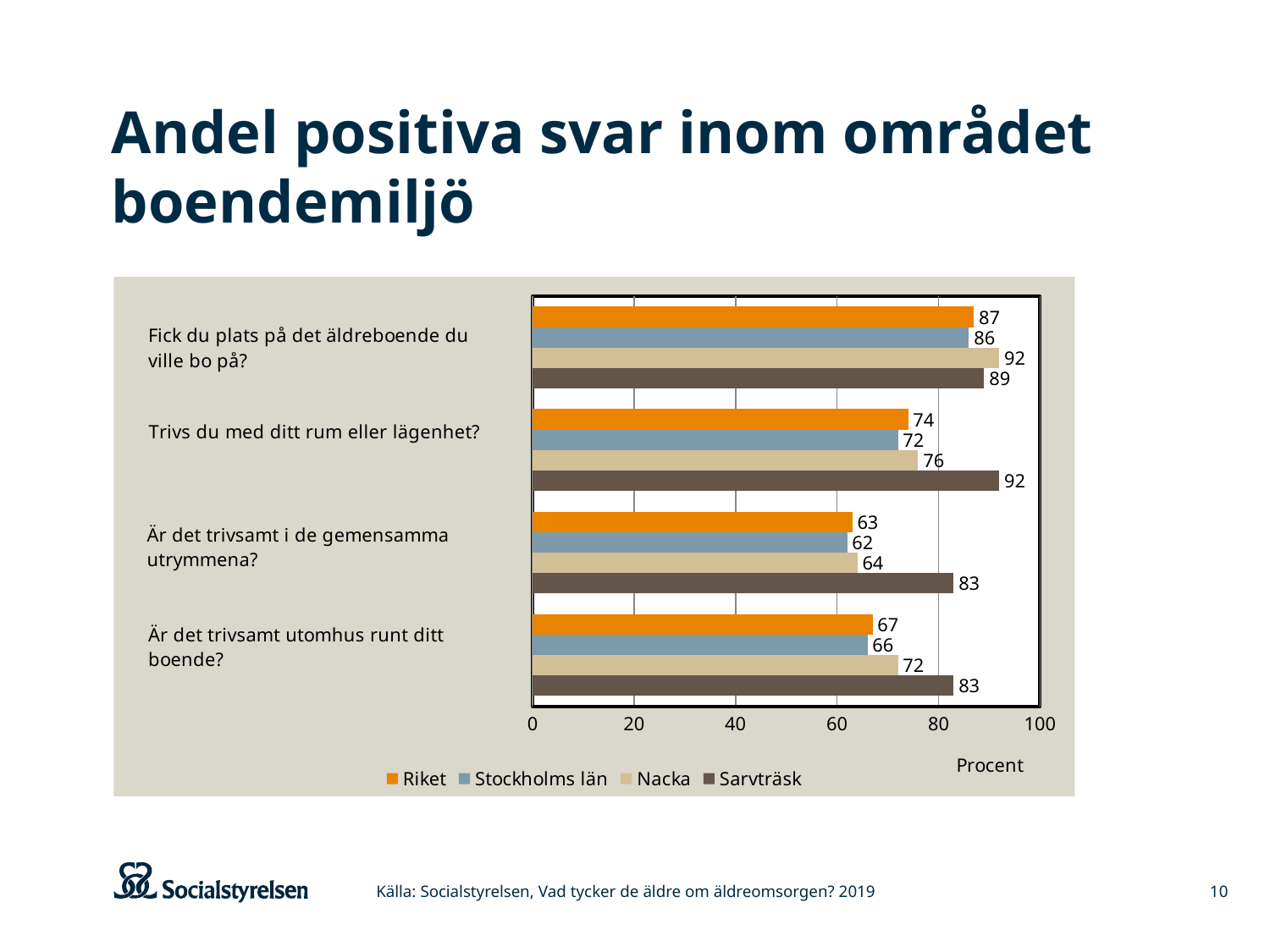
What is the label of the horizontal axis? Procent Which is larger on "Fick du plats på det äldreboende du ville bo på?": Nacka or Sarvträsk? Nacka Which series has the highest value on "Är det trivsamt i de gemensamma utrymmena?"? Sarvträsk What is the value for Stockholms län on "Är det trivsamt utomhus runt ditt boende?"? 66 Which series has the lowest value on "Är det trivsamt utomhus runt ditt boende?"? Stockholms län What kind of chart is shown on the slide? Bar chart What is the value for Sarvträsk on "Trivs du med ditt rum eller lägenhet?"? 92 How many questions (categories) are shown on the chart? 4 What is the value for Nacka on "Fick du plats på det äldreboende du ville bo på?"? 92 How many series does the legend list? 4 What is the value for Riket on "Är det trivsamt i de gemensamma utrymmena?"? 63 What is the difference between Sarvträsk and Riket on "Trivs du med ditt rum eller lägenhet?"? 18